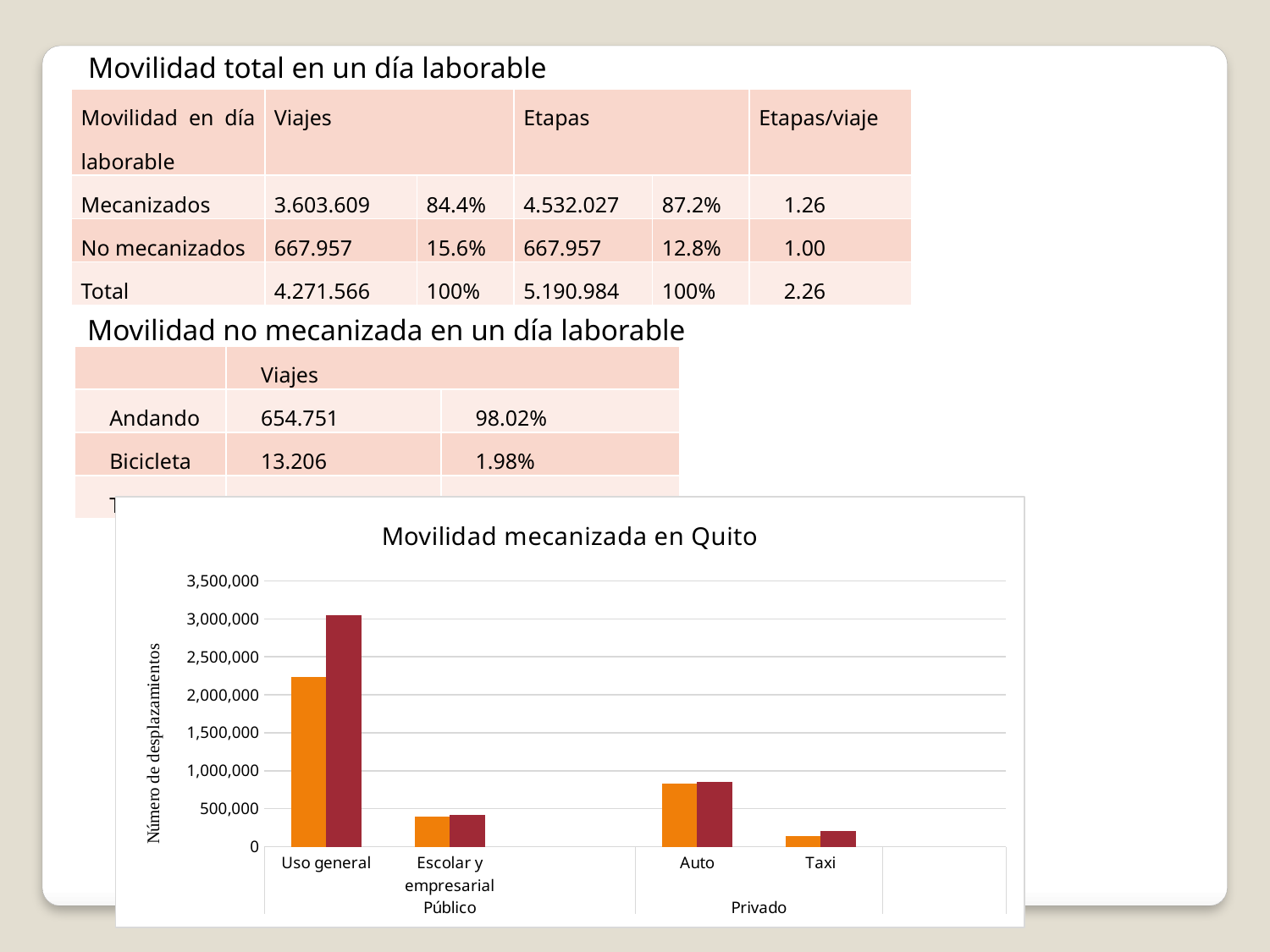
In the chart 'Movilidad mecanizada en Quito', which category has the highest values? Uso general How many categories are shown on the x axis of the chart 'Movilidad mecanizada en Quito'? 4 In the chart 'Movilidad mecanizada en Quito', is the orange bar for Uso general greater or less than 2,000,000? greater In the chart 'Movilidad mecanizada en Quito', is the dark red bar for Uso general greater or less than 2,500,000? greater What is the title of the chart on the slide? Movilidad mecanizada en Quito What is the label of the vertical axis in the chart 'Movilidad mecanizada en Quito'? Número de desplazamientos In the chart 'Movilidad mecanizada en Quito', which is larger for Uso general: the orange bar or the dark red bar? the dark red bar What type of chart is 'Movilidad mecanizada en Quito'? bar chart In the chart 'Movilidad mecanizada en Quito', is the orange bar for Auto greater or less than 1,000,000? less In the chart 'Movilidad mecanizada en Quito', which is larger: the orange bar for Auto or the orange bar for Escolar y empresarial? Auto In the chart 'Movilidad mecanizada en Quito', which category has the lowest values? Taxi